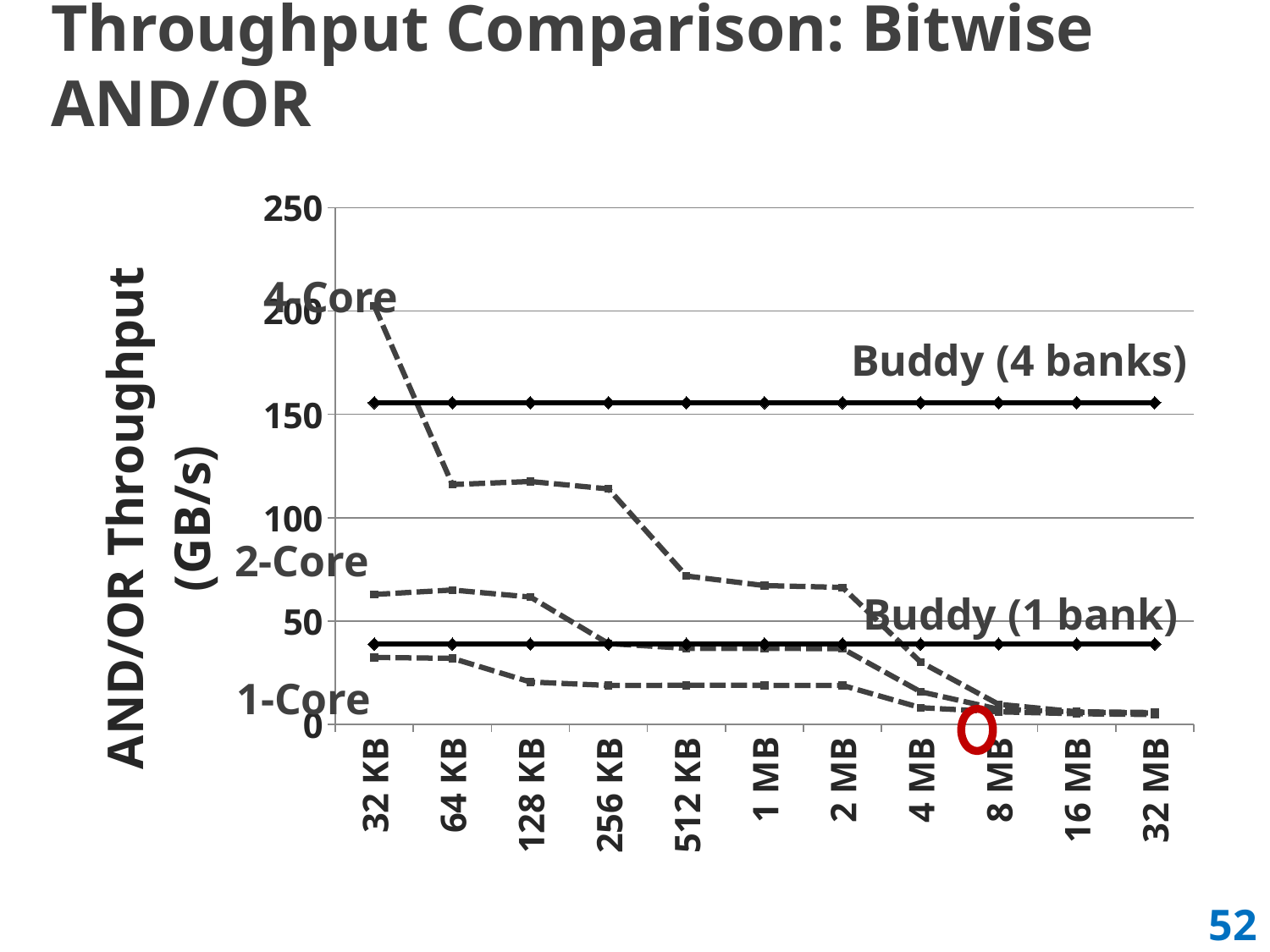
How many data series (lines) are plotted in the chart? 5 Is the value for Buddy (4 banks) at 32 KB greater or less than 100? greater What is the title of the slide containing the chart? Throughput Comparison: Bitwise AND/OR Is the value for 4-Core at 32 KB greater or less than 150? greater What is the label of the y axis? AND/OR Throughput (GB/s) Is the value for Buddy (1 bank) at 32 MB greater or less than 50? less Which series has the highest value at 32 MB? Buddy (4 banks) At 32 KB, which is larger: 4-Core or Buddy (4 banks)? 4-Core Does the 4-Core line rise or fall as the x axis goes from 32 KB to 32 MB? fall How many categories are shown on the x axis of the chart? 11 What kind of chart is shown on the slide? line chart